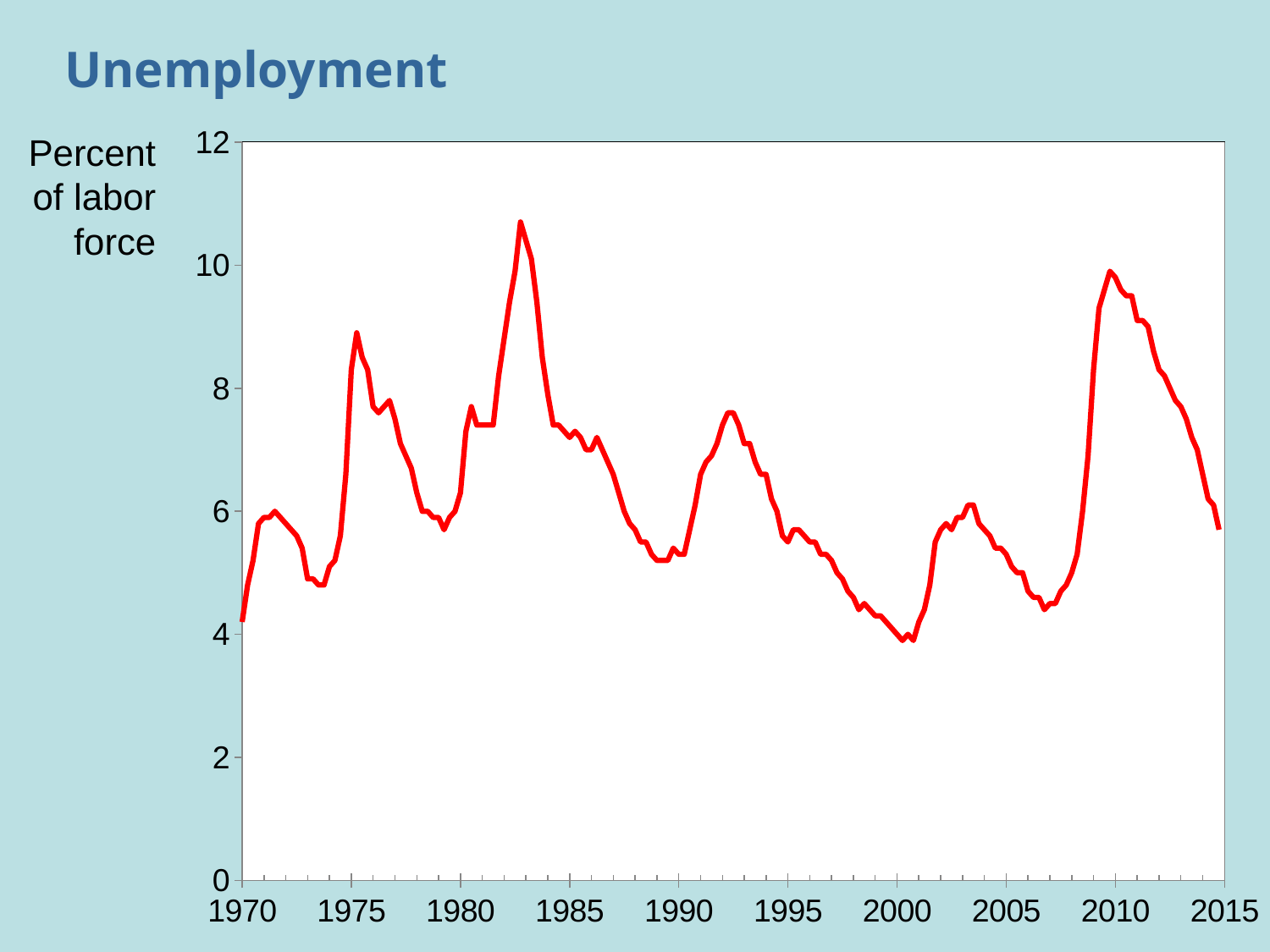
Around which year does the unemployment rate reach its highest point? 1983 What is the title of the chart? Unemployment Does the unemployment rate rise or fall between 2007 and 2009? rise Which peak is higher, the one around 1983 or the one around 2010? around 1983 Does the unemployment rate rise or fall between 2010 and 2015? fall What is the label on the vertical axis of the chart? Percent of labor force Is the unemployment rate in 1975 greater or less than 8? greater Is the unemployment rate in 1983 greater or less than 10? greater Is the unemployment rate in 2000 greater or less than 6? less What kind of chart is shown on the slide? line chart